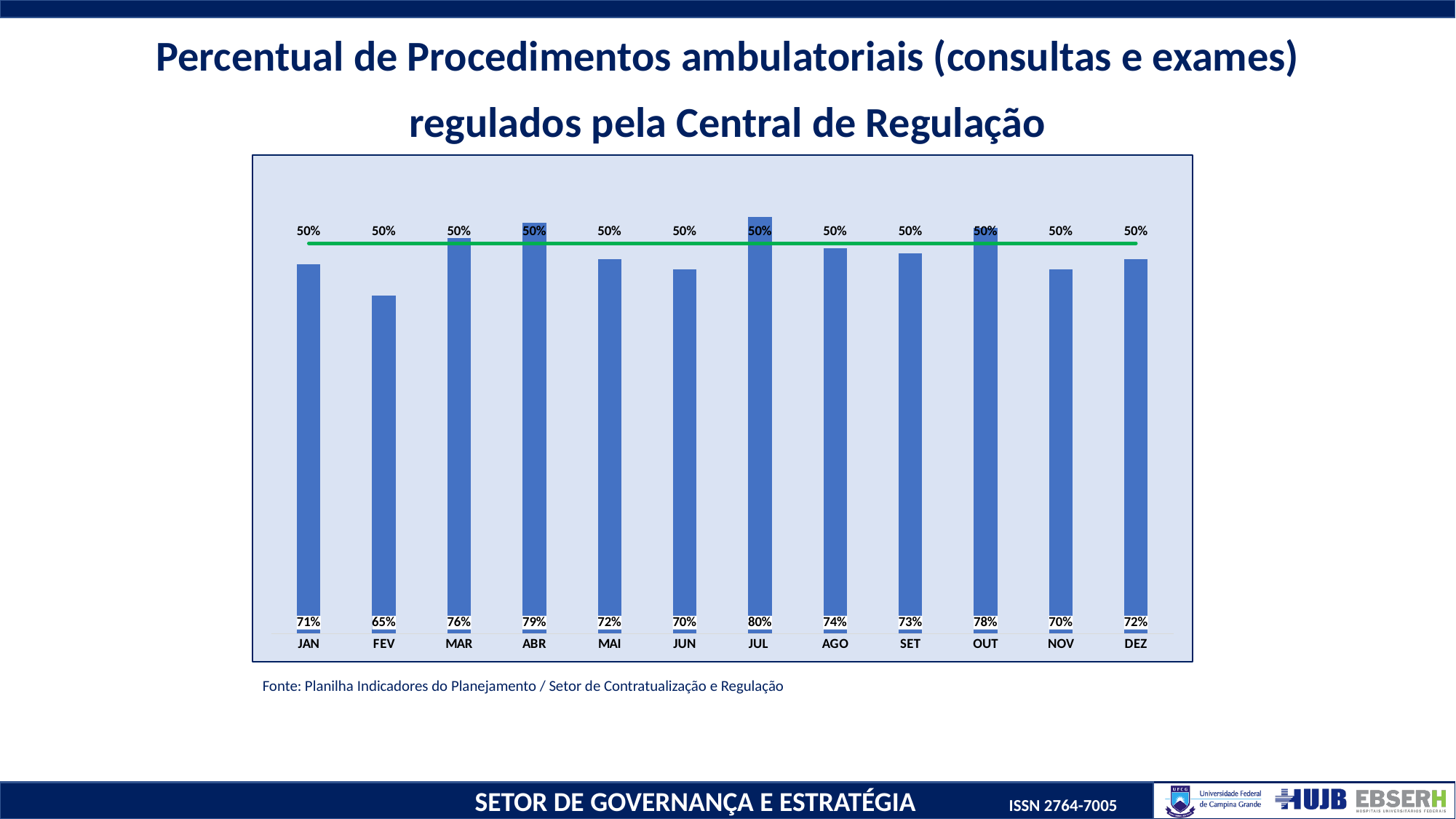
What is the value for OUT? 78% What is the value for FEV? 65% What value does the green horizontal line represent in every month? 50% What is the value for ABR? 79% What is the difference between the values for JUL and FEV? 15% What is the difference between the values for MAR and JAN? 5% Which is larger, the value for AGO or the value for SET? AGO How many months are shown on the x axis? 12 Which month has the lowest value? FEV Which month has the highest value? JUL What is the value for JUL? 80% What kind of chart is shown on the slide? Bar chart